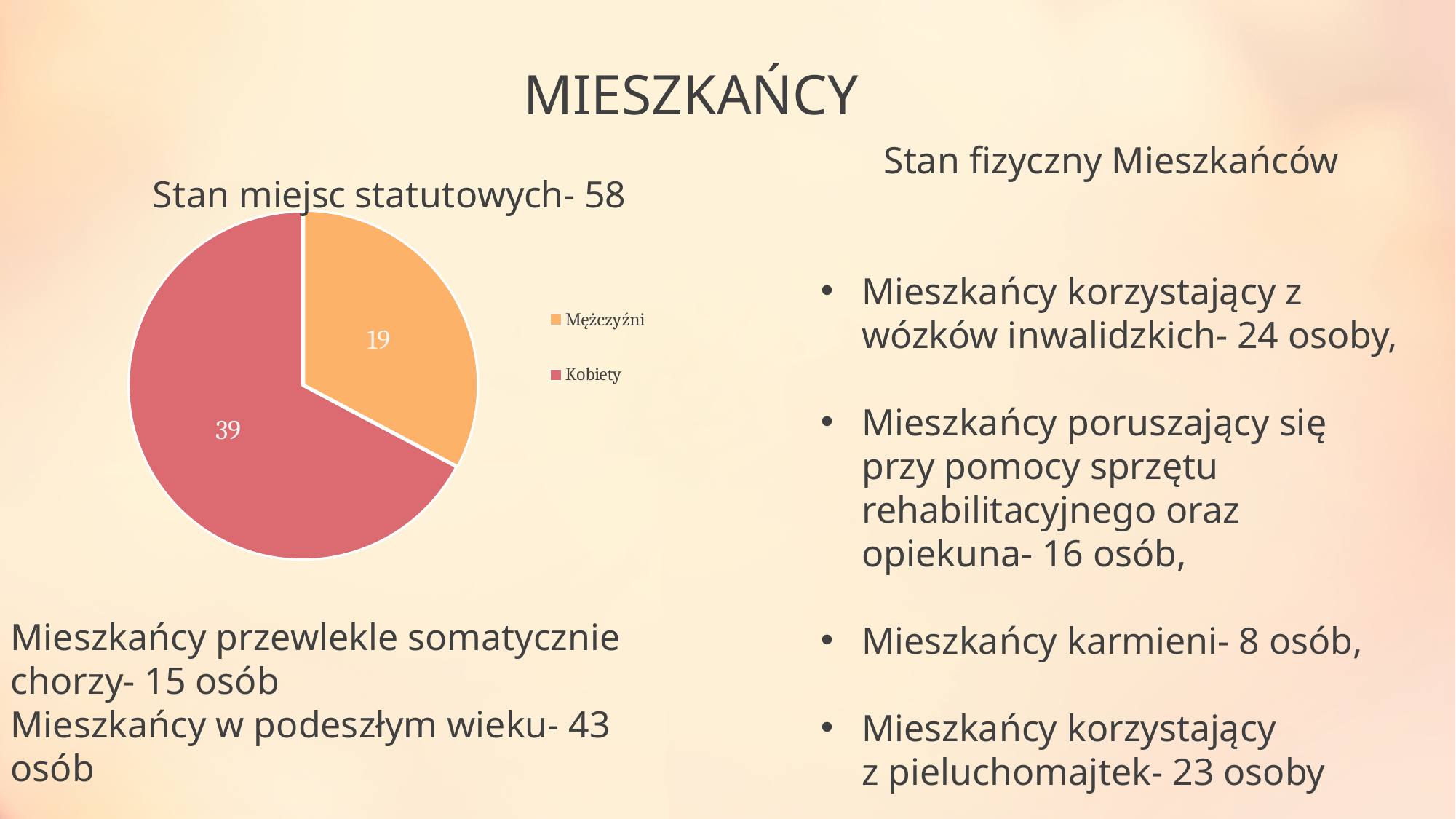
How many entries does the legend of the pie chart list? 2 What is the value for Kobiety in the pie chart? 39 What type of chart is shown on the slide? pie chart What is the difference between the values for Kobiety and Mężczyźni? 20 Which is larger, the value for Kobiety or for Mężczyźni? Kobiety Which category has the smallest slice in the pie chart? Mężczyźni Which category has the largest slice in the pie chart? Kobiety What is the total of the two slices in the pie chart? 58 What colour is the Kobiety slice in the pie chart? red How many slices does the pie chart have? 2 What is the title of the pie chart? Stan miejsc statutowych- 58 What is the value for Mężczyźni in the pie chart? 19